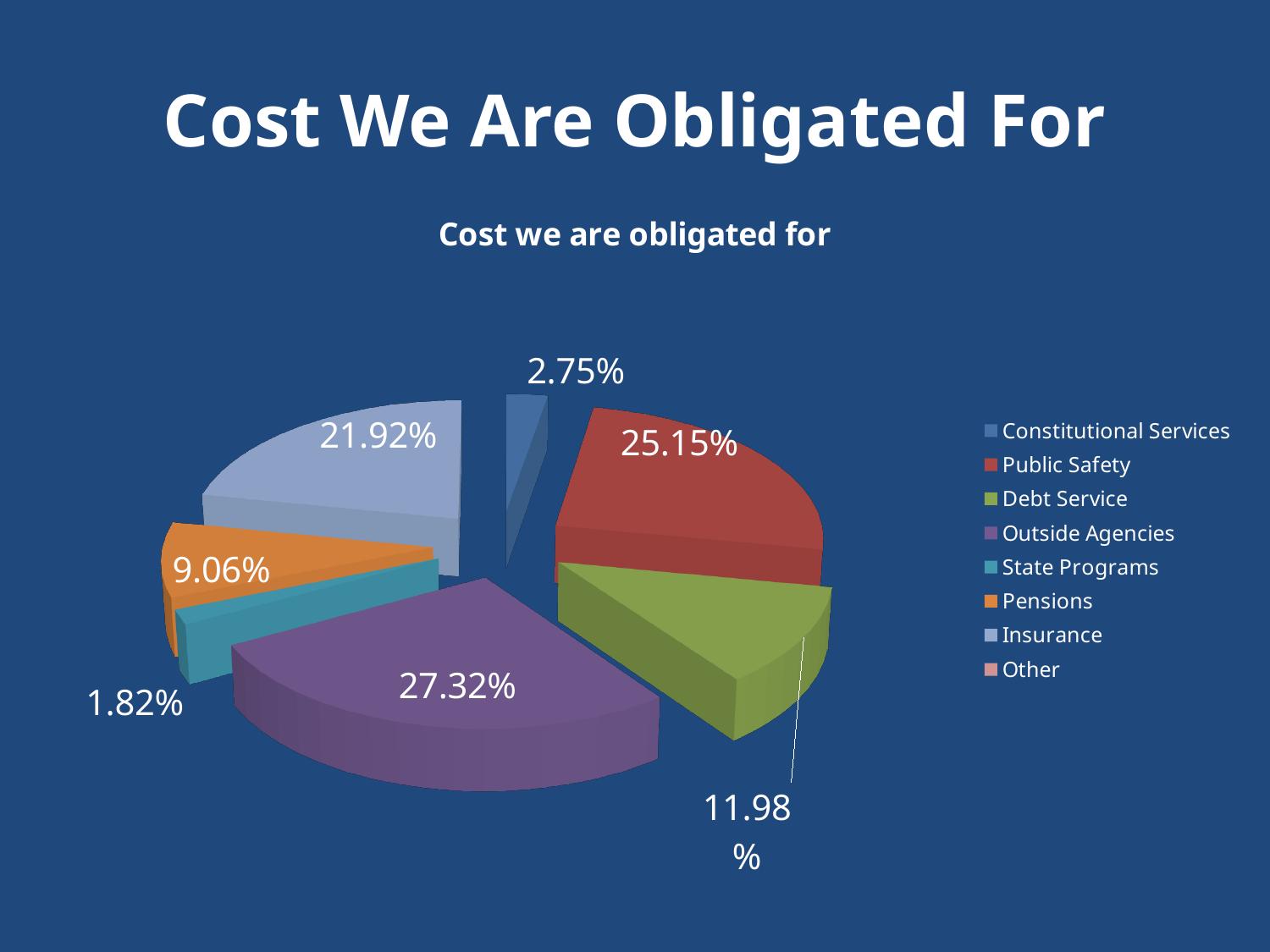
Which is larger, the share for Public Safety or the share for Insurance? Public Safety What share of the pie is Debt Service? 11.98% What share of the pie is Outside Agencies? 27.32% What share of the pie is Public Safety? 25.15% Which category has the largest share of the pie? Outside Agencies What type of chart is shown on the slide? Pie chart How many categories does the legend list? 8 What is the title of the chart? Cost we are obligated for What is the difference between the shares for Outside Agencies and Public Safety? 2.17%